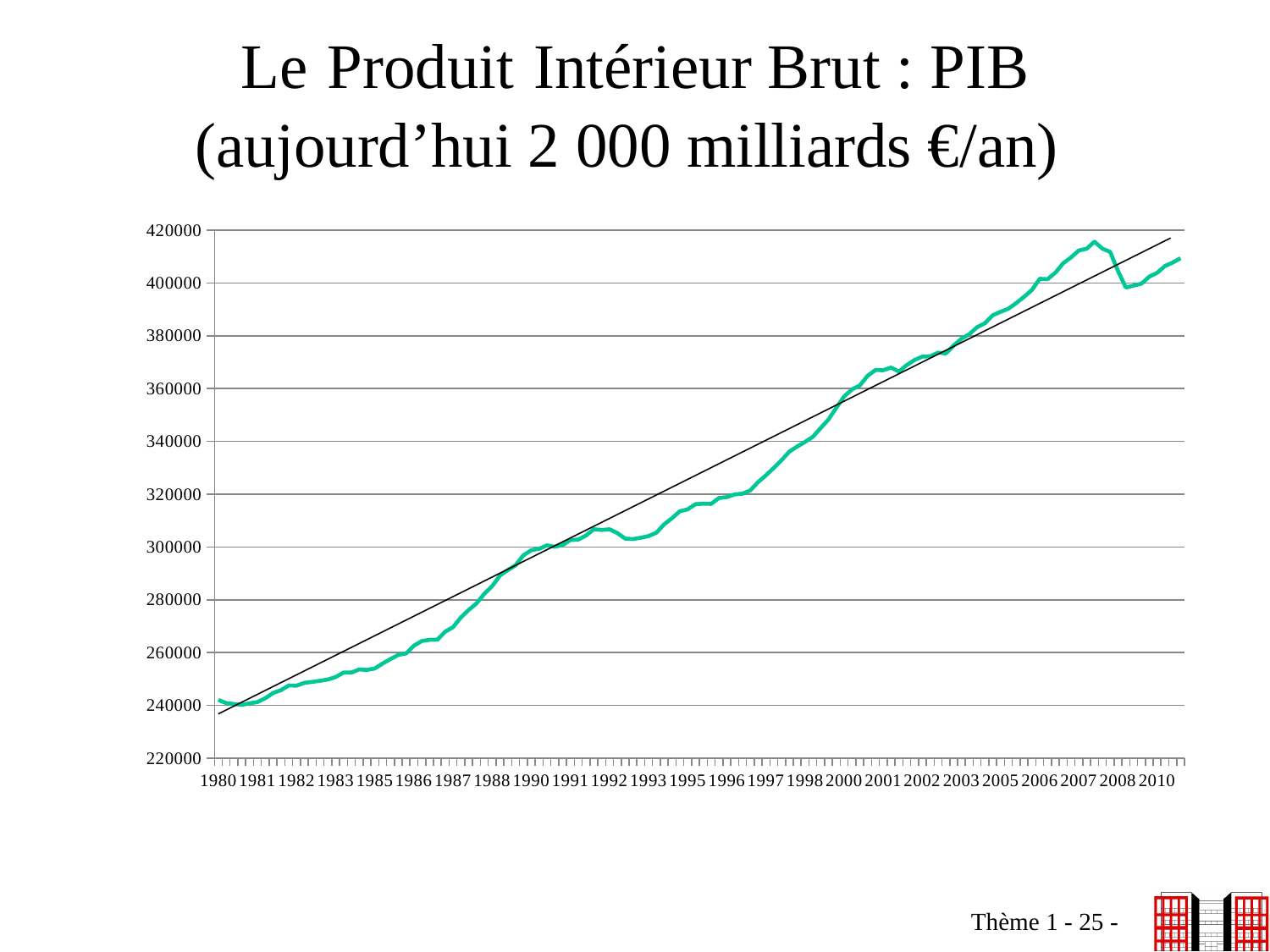
Is the value of the green line for 2010 greater or less than 400000? greater Is the value of the green line for 1990 greater or less than 320000? less How many lines are plotted on the chart? 2 Overall, does the green line rise or fall from 1980 to 2010? Rise Which year has the larger value on the green line, 1985 or 2007? 2007 Is the value of the green line for 1980 greater or less than 260000? less What kind of chart is shown on the slide? Line chart How many year labels are shown on the x axis? 25 What is the title of the slide containing the chart? Le Produit Intérieur Brut : PIB (aujourd'hui 2 000 milliards €/an) What is the highest value shown on the y axis? 420000